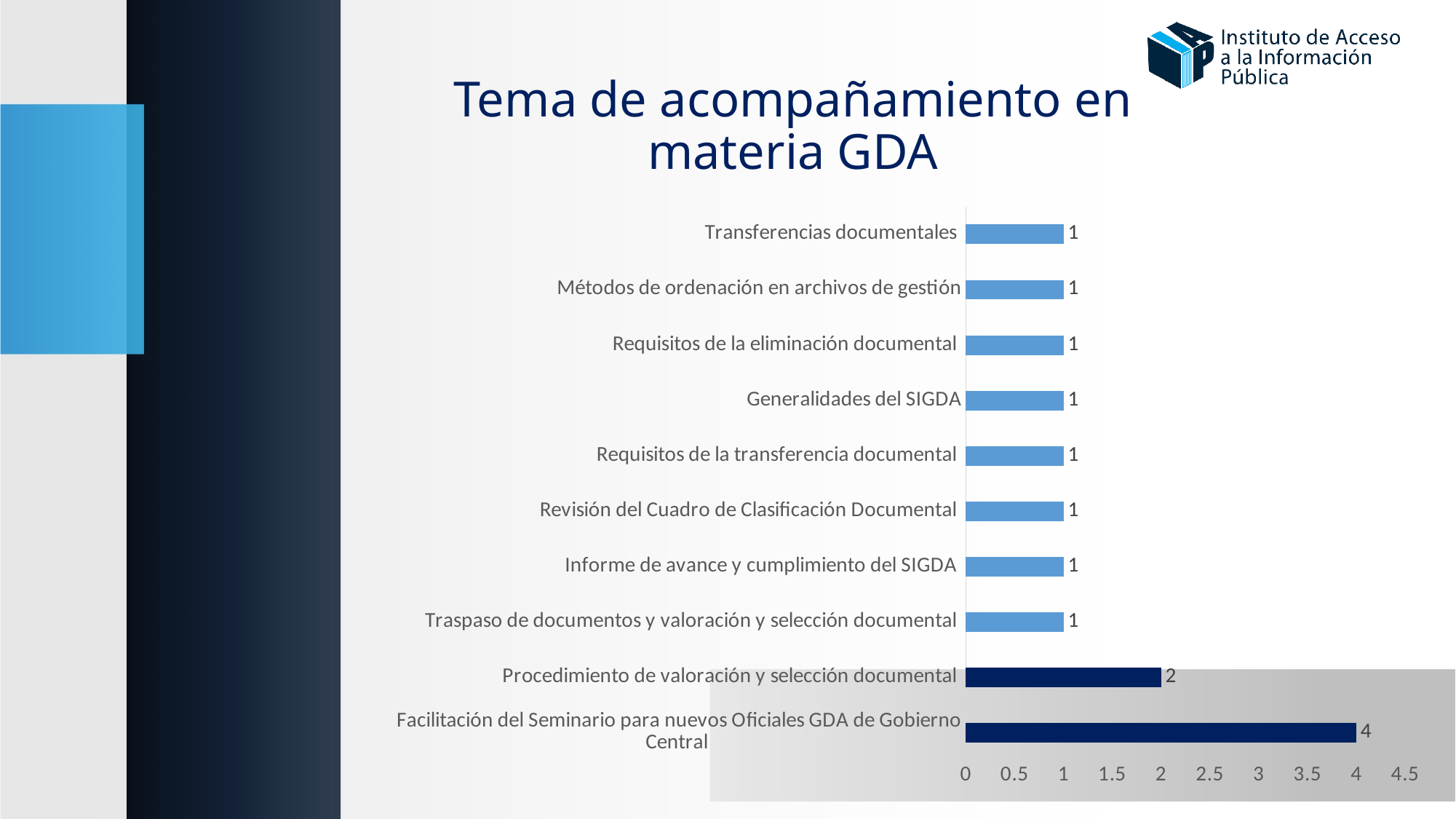
How many categories are shown in the chart? 10 Is the value for Facilitación del Seminario para nuevos Oficiales GDA de Gobierno Central greater or less than 3? greater What is the value for Transferencias documentales? 1 What is the difference between the values for Facilitación del Seminario para nuevos Oficiales GDA de Gobierno Central and Procedimiento de valoración y selección documental? 2 What kind of chart is shown on the slide? bar chart What is the value for Generalidades del SIGDA? 1 How many categories have a value of 1? 8 What is the value for Procedimiento de valoración y selección documental? 2 Which category has the highest value? Facilitación del Seminario para nuevos Oficiales GDA de Gobierno Central Which is larger: the value for Procedimiento de valoración y selección documental or the value for Revisión del Cuadro de Clasificación Documental? Procedimiento de valoración y selección documental What is the title of the slide? Tema de acompañamiento en materia GDA What is the value for Facilitación del Seminario para nuevos Oficiales GDA de Gobierno Central? 4